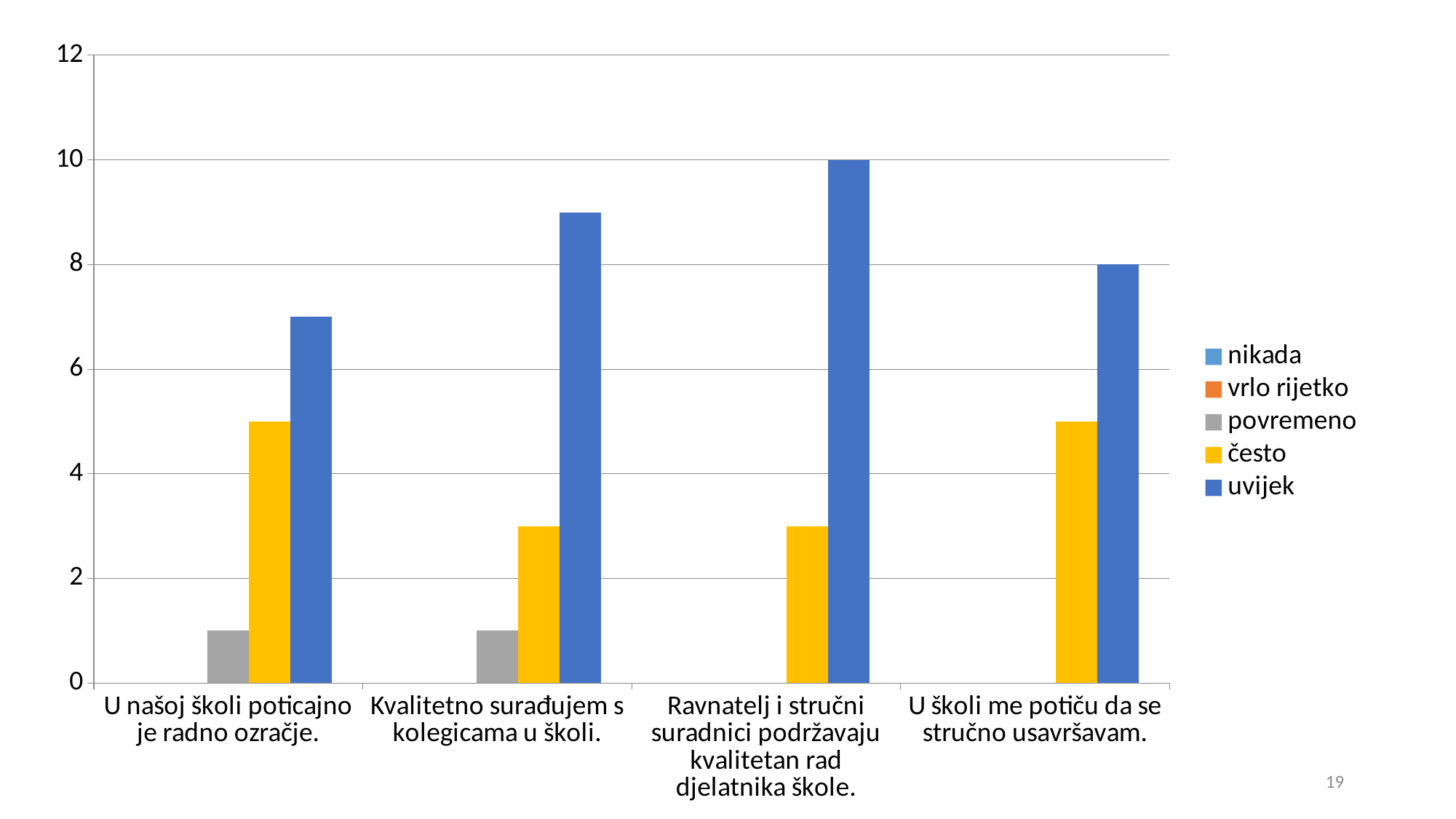
Which category has the highest "uvijek" value? Ravnatelj i stručni suradnici podržavaju kvalitetan rad djelatnika škole. How many categories are shown on the x axis? 4 Which legend entry is shown in yellow? često Which category has the lowest "uvijek" value? U našoj školi poticajno je radno ozračje. What kind of chart is shown on the slide? bar chart Is the "povremeno" value for "Kvalitetno surađujem s kolegicama u školi." greater or less than 2? less How many series does the legend list? 5 Which is larger for "U školi me potiču da se stručno usavršavam.": the "često" value or the "uvijek" value? uvijek Is the "često" value for "U našoj školi poticajno je radno ozračje." greater or less than 4? greater What is the value of "uvijek" for "Ravnatelj i stručni suradnici podržavaju kvalitetan rad djelatnika škole."? 10 Is the "uvijek" value for "Kvalitetno surađujem s kolegicama u školi." greater or less than 8? greater What is the value of "uvijek" for "U školi me potiču da se stručno usavršavam."? 8